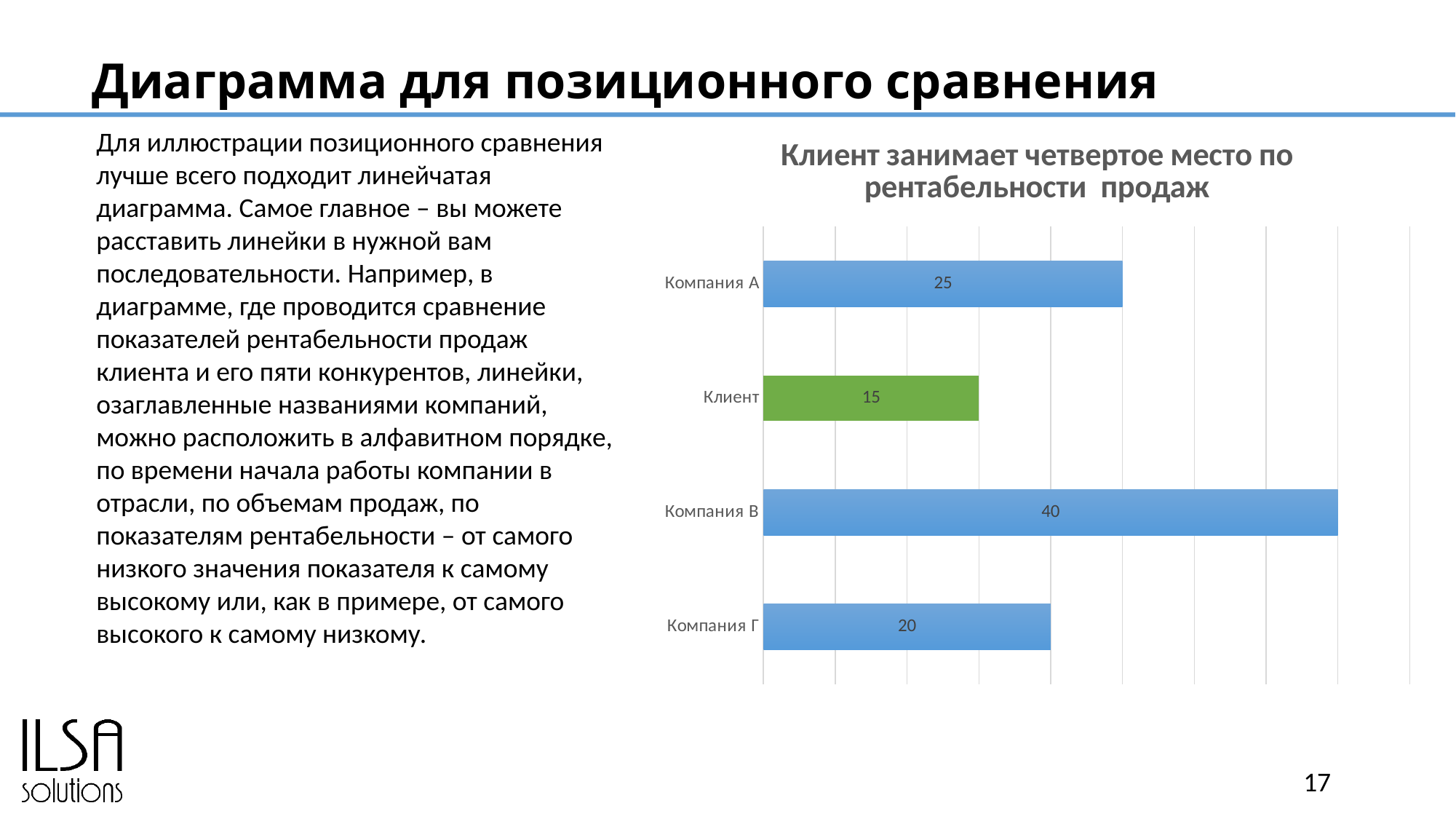
What value is shown for Компания А? 25 What kind of chart is shown on the slide? Bar chart What is the difference between the values for Компания В and Клиент? 25 Which category has the lowest value? Клиент What is the title of the chart? Клиент занимает четвертое место по рентабельности продаж What value is shown for Компания В? 40 What is the difference between the values for Компания А and Компания Г? 5 Which is larger, the value for Компания А or the value for Компания Г? Компания А Which category has the highest value? Компания В What value is shown for Клиент? 15 How many categories are shown in the chart? 4 What value is shown for Компания Г? 20